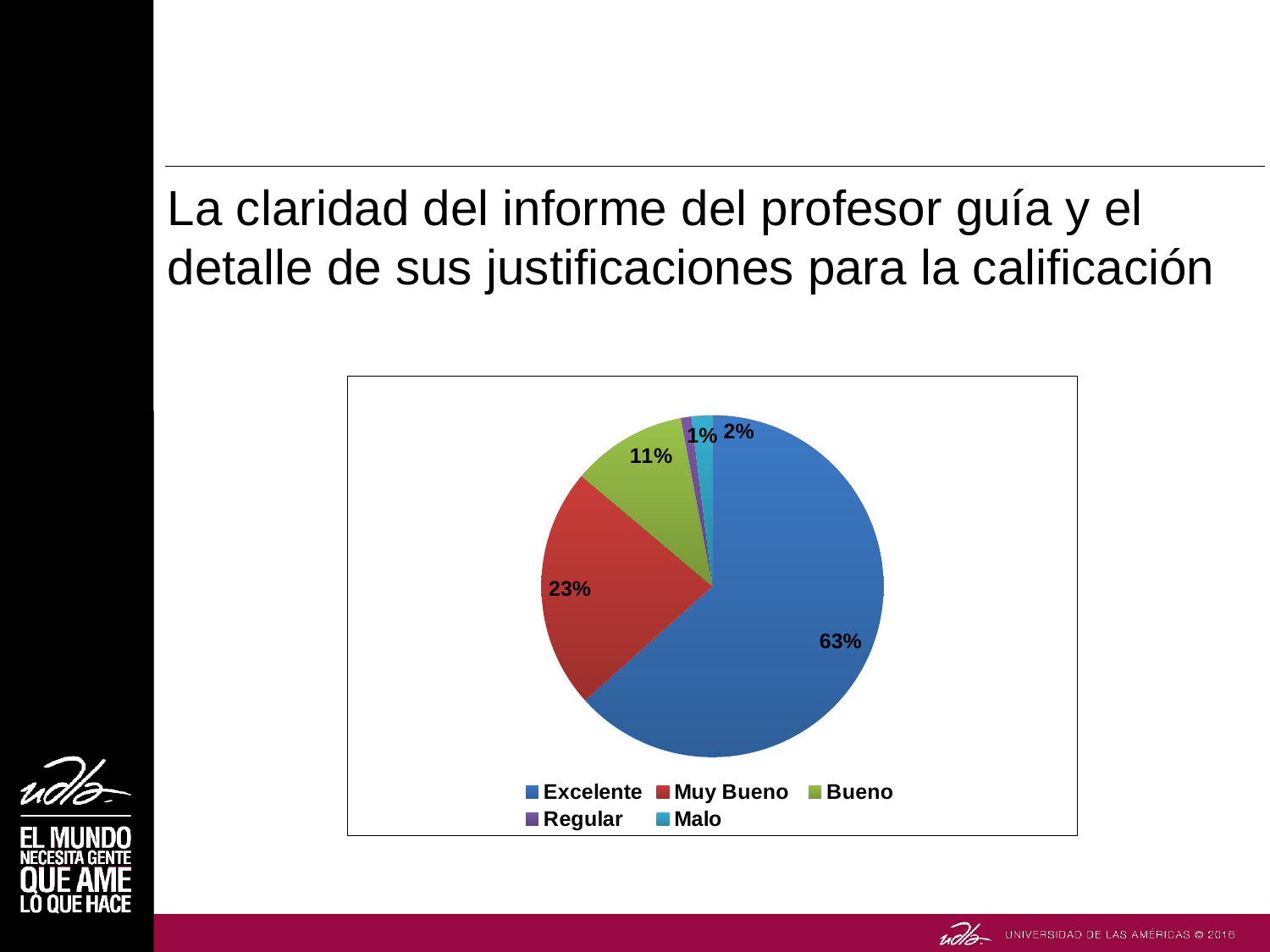
What colour is the Excelente slice? blue What percentage of the pie corresponds to Bueno? 11% What type of chart is shown on the slide? pie chart What percentage of the pie corresponds to Regular? 1% Which category has the largest share of the pie? Excelente How many categories does the legend list? 5 Which is larger, the share for Bueno or the share for Malo? Bueno What is the difference in percentage points between Excelente and Muy Bueno? 40 What percentage of the pie corresponds to Muy Bueno? 23% What percentage of the pie corresponds to Malo? 2% Which category has the smallest share of the pie? Regular What percentage of the pie corresponds to Excelente? 63%